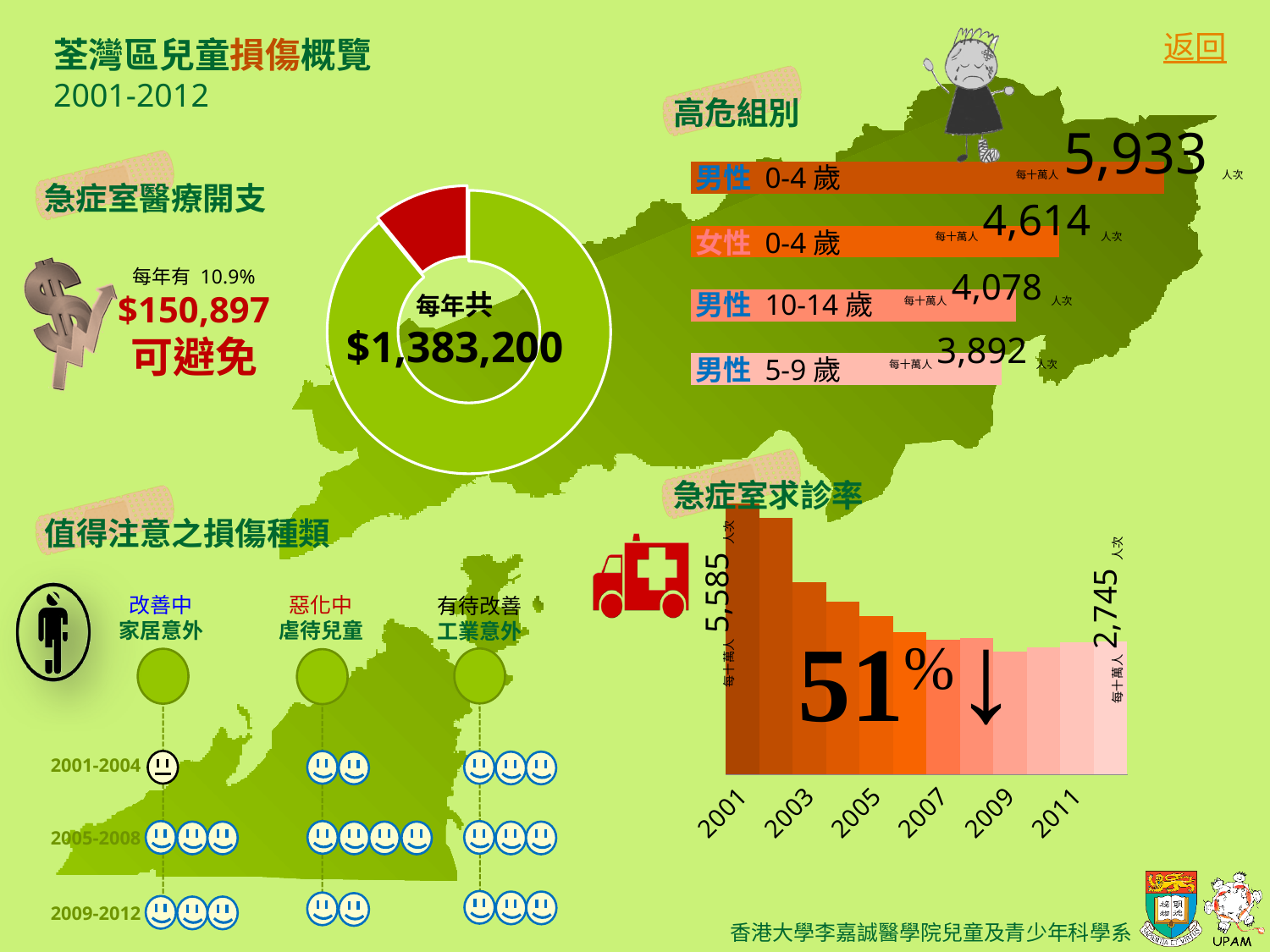
In the 高危組別 bar chart, how many groups are shown? 4 In the 急症室求診率 chart, what is the value labelled for 2001? 5,585 In the 急症室求診率 chart, do the values rise or fall from 2001 onwards? fall In the 急症室醫療開支 donut chart, what share of the annual spending is marked as avoidable (可避免)? 10.9% In the 高危組別 bar chart, what is the value for 男性 0-4 歲? 5,933 In the 高危組別 bar chart, which is larger: 女性 0-4 歲 or 男性 10-14 歲? 女性 0-4 歲 In the 急症室醫療開支 donut chart, what is the avoidable amount per year? $150,897 In the 急症室醫療開支 donut chart, what is the total annual amount shown in the centre? $1,383,200 In the 高危組別 bar chart, which group has the lowest value? 男性 5-9 歲 In the 高危組別 bar chart, what is the difference between 男性 0-4 歲 and 女性 0-4 歲? 1,319 In the 急症室求診率 chart, what percentage decrease is printed on the chart? 51% In the 值得注意之損傷種類 pictogram, how many faces are shown for 虐待兒童 in 2005-2008? 4